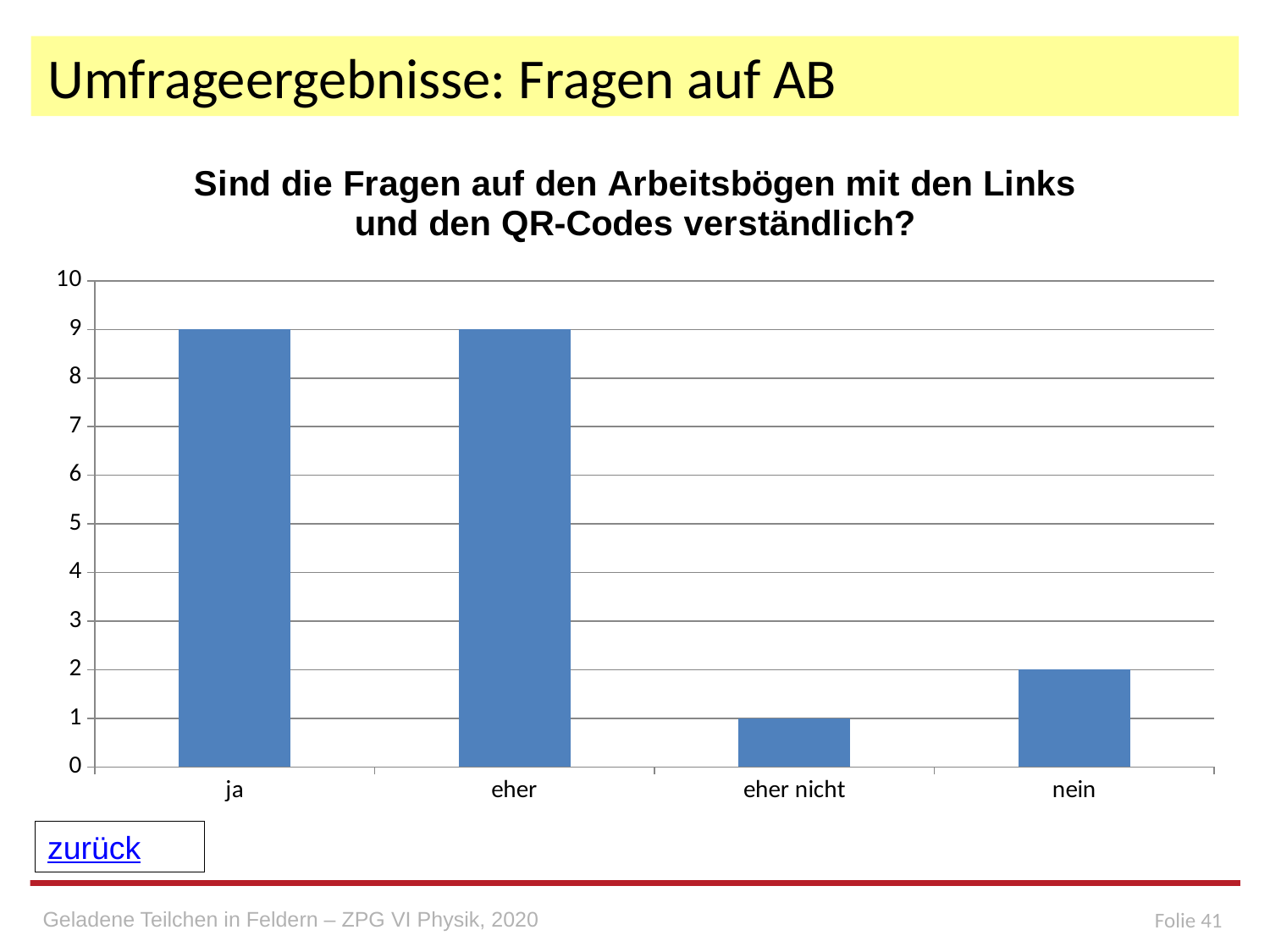
What is the difference between the value for "ja" and the value for "nein"? 7 Is the value for "nein" greater or less than 5? less Is the value for "ja" greater or less than 5? greater What is the value for "eher"? 9 What is the title of the chart? Sind die Fragen auf den Arbeitsbögen mit den Links und den QR-Codes verständlich? What is the value for "nein"? 2 Which is larger, the value for "nein" or the value for "eher nicht"? nein How many categories are shown on the x axis of the chart? 4 What is the value for "eher nicht"? 1 What is the value for "ja"? 9 Which category has the lowest value? eher nicht What type of chart is shown on the slide? bar chart